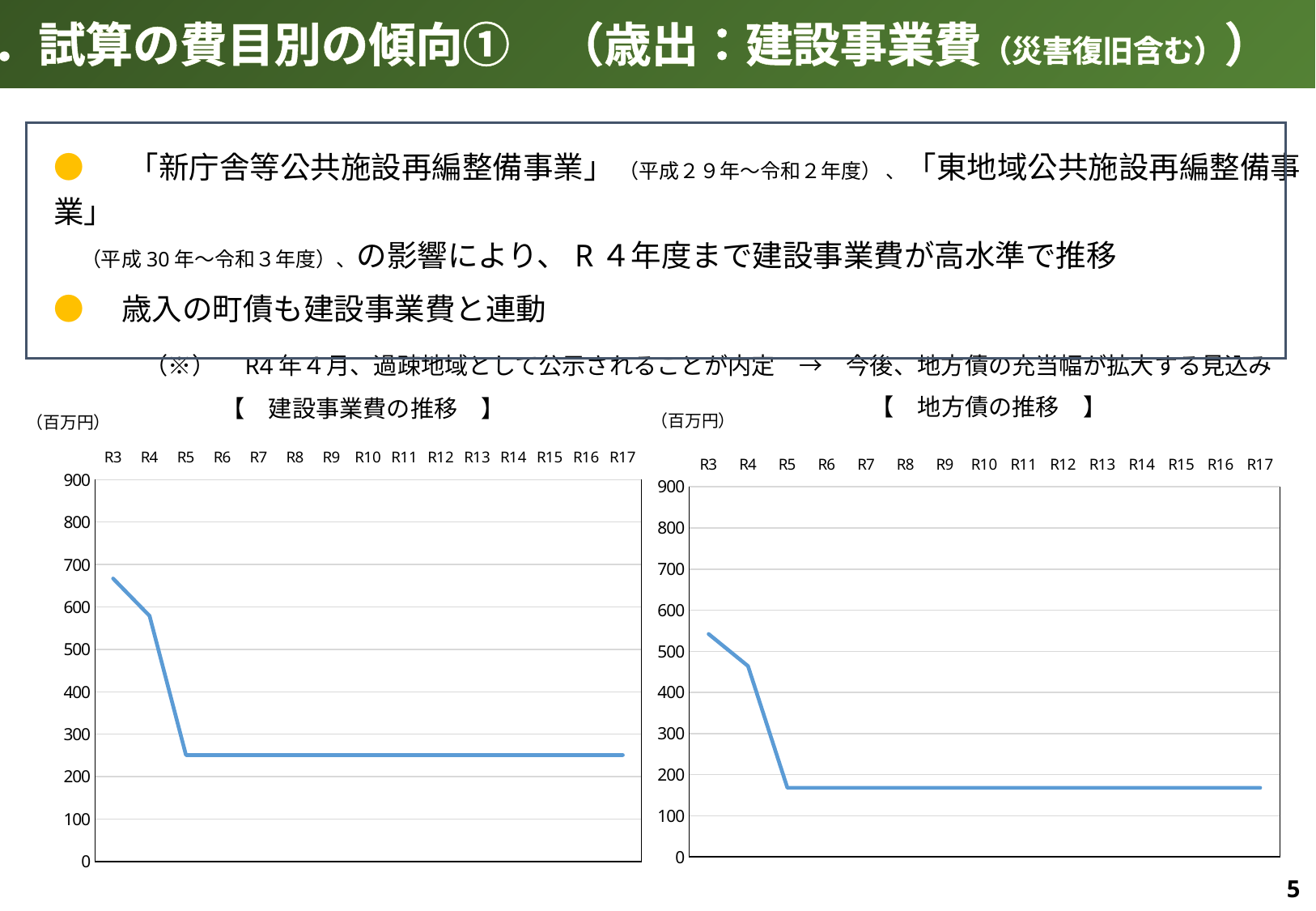
In the 建設事業費の推移 chart, is the value for R10 greater or less than 300? less What unit is shown above the y axis of the 地方債の推移 chart? 百万円 In the 建設事業費の推移 chart, which year has the highest value? R3 How many fiscal years are plotted on the x axis of the 建設事業費の推移 chart? 15 In the 地方債の推移 chart, is the value for R12 greater or less than 200? less What kind of chart is the 建設事業費の推移 chart? line chart What kind of chart is the 地方債の推移 chart? line chart In the 建設事業費の推移 chart, is the value for R3 greater or less than 600? greater In the 建設事業費の推移 chart, do the values rise or fall from R3 to R5? fall In the 建設事業費の推移 chart, is the value for R4 larger or smaller than the value for R5? larger In the 地方債の推移 chart, which year has the highest value? R3